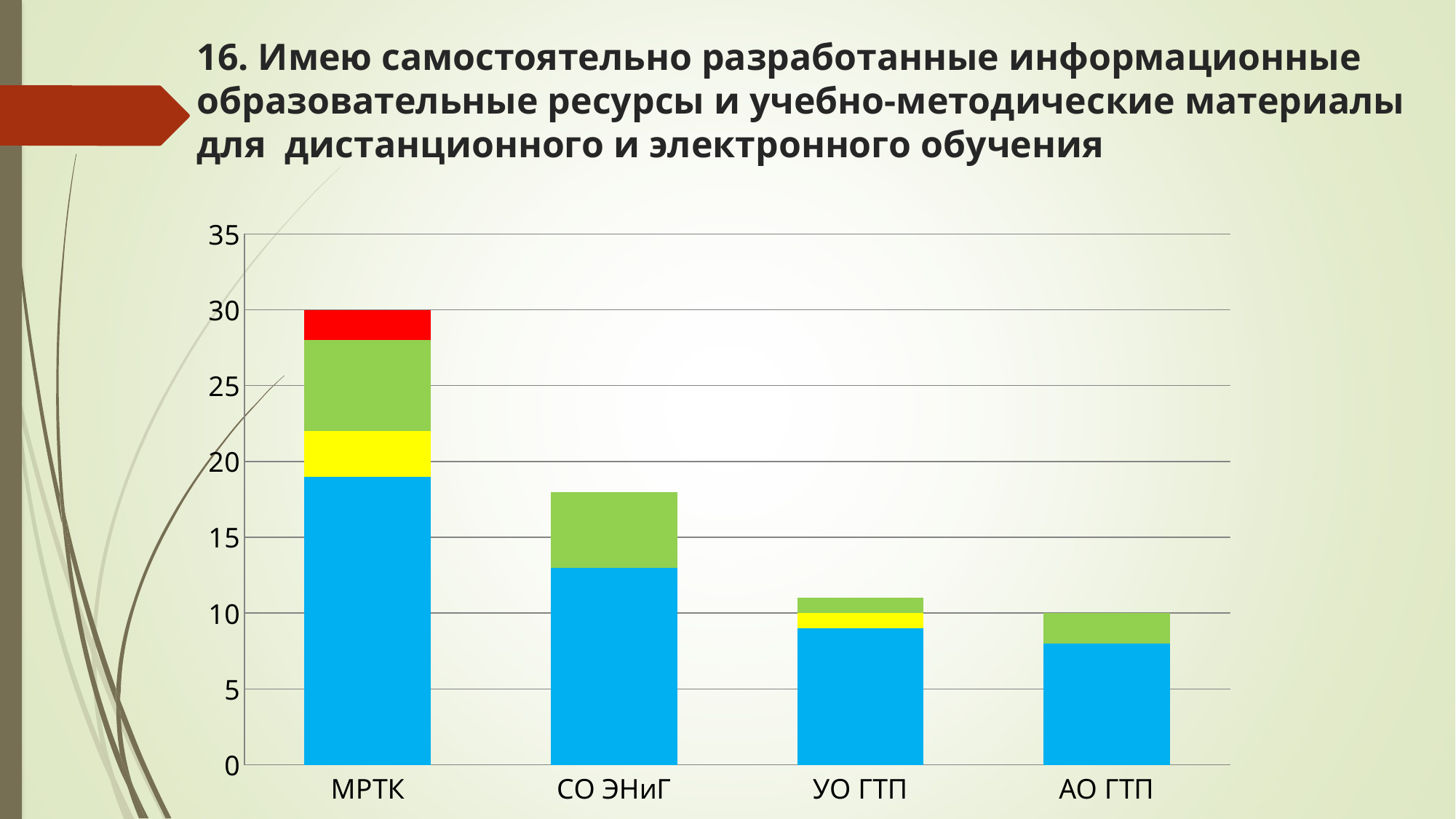
What is the total height of the stacked bar for МРТК? 30 Is the total value for УО ГТП greater or less than 15? less Do the total bar heights rise or fall from left to right across the categories? Fall Which has the larger total, СО ЭНиГ or УО ГТП? СО ЭНиГ How many coloured segments make up the bar for МРТК? 4 Which category has the tallest stacked bar? МРТК What colour is the bottom segment of every bar in the chart? Blue Is the total value for СО ЭНиГ greater or less than 20? less Is the total value for СО ЭНиГ greater or less than 15? greater What is the total height of the stacked bar for АО ГТП? 10 How many categories are shown on the x axis of the chart? 4 What kind of chart is shown on the slide? Stacked bar chart